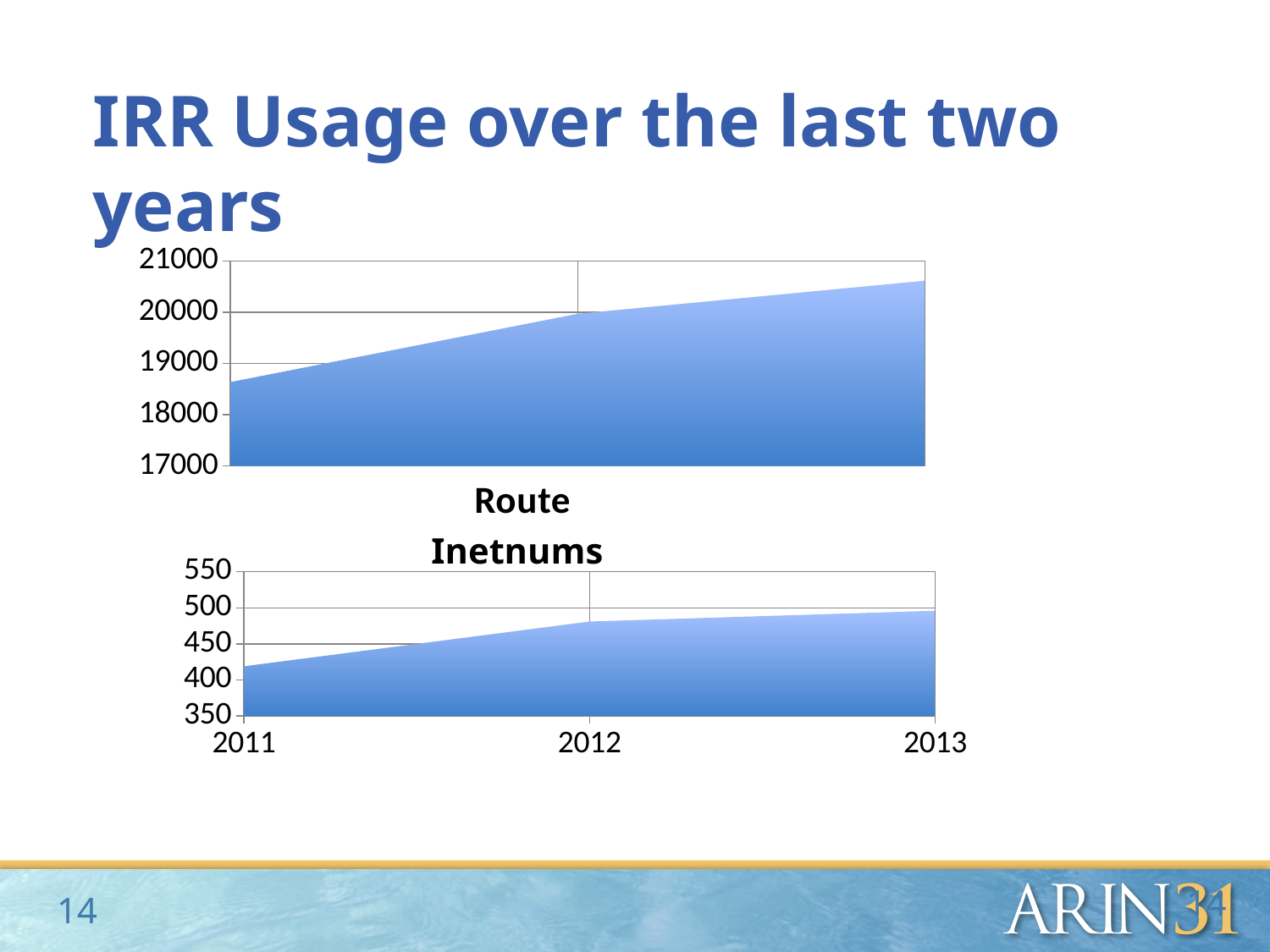
How many years are plotted along the x axis of the "Inetnums" chart? 3 What kind of chart is the bottom chart titled "Inetnums"? area chart In the "Route" chart, do the values rise or fall from 2011 to 2013? rise In the "Route" chart, which year has the highest value? 2013 In the "Inetnums" chart, which year has the lowest value? 2011 In the "Inetnums" chart, is the value for 2013 greater or less than 450? greater In the "Route" chart, is the value for 2011 greater or less than 19000? less What is the title of the top chart on the slide? Route In the "Inetnums" chart, is the value for 2011 greater or less than 450? less In the "Inetnums" chart, do the values rise or fall from 2011 to 2013? rise What kind of chart is the top chart titled "Route"? area chart